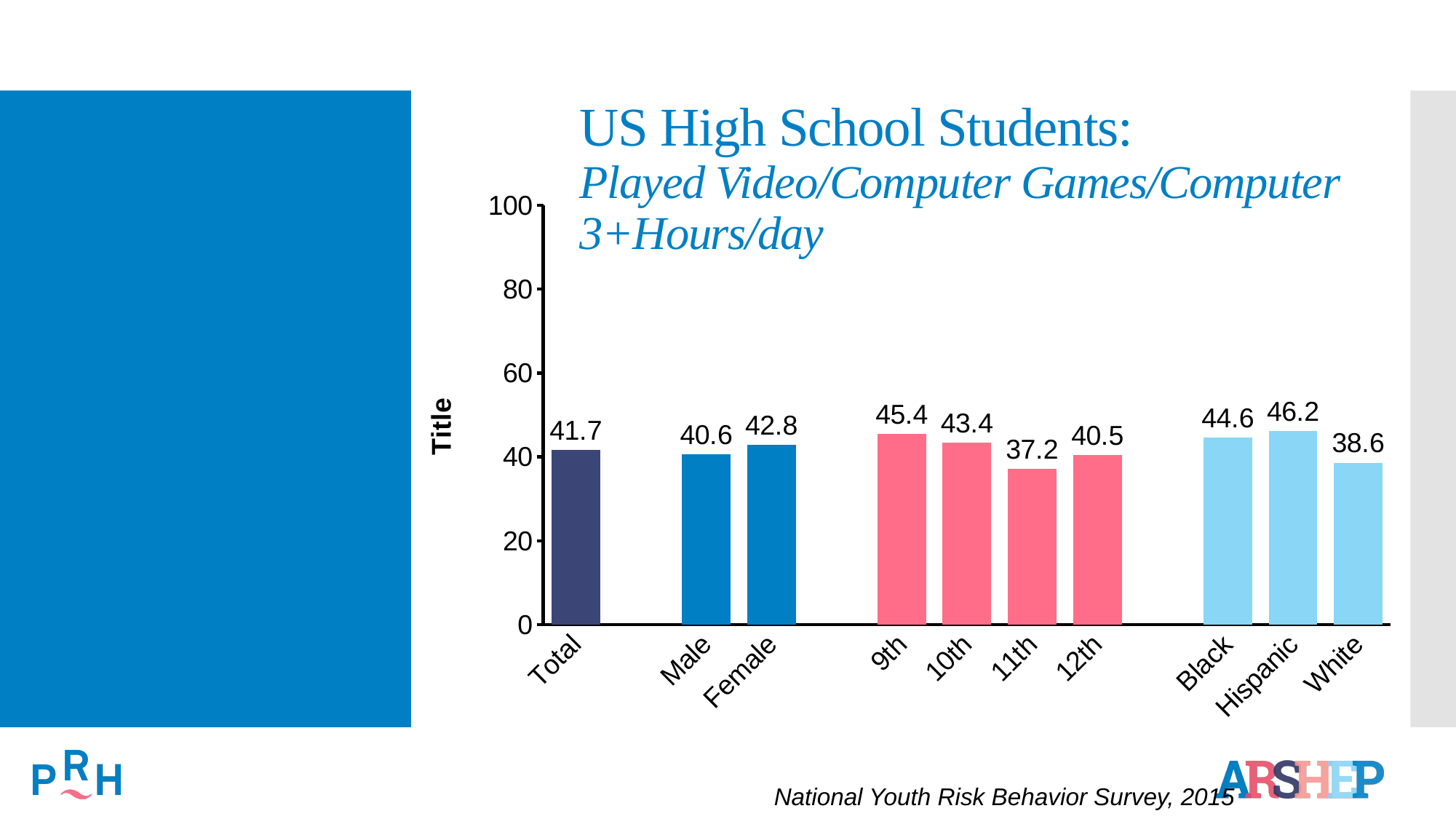
How many categories are shown on the x axis? 10 What is the value for 11th? 37.2 What is the value for Total? 41.7 Which category has the highest value? Hispanic Which category has the lowest value? 11th What is the difference between the values for 9th and 12th? 4.9 What is the difference between the values for Female and Male? 2.2 What is the value for Female? 42.8 What kind of chart is shown on the slide? bar chart Which is larger, the value for Black or the value for White? Black What is the title of the chart? US High School Students: Played Video/Computer Games/Computer 3+Hours/day What is the value for Hispanic? 46.2